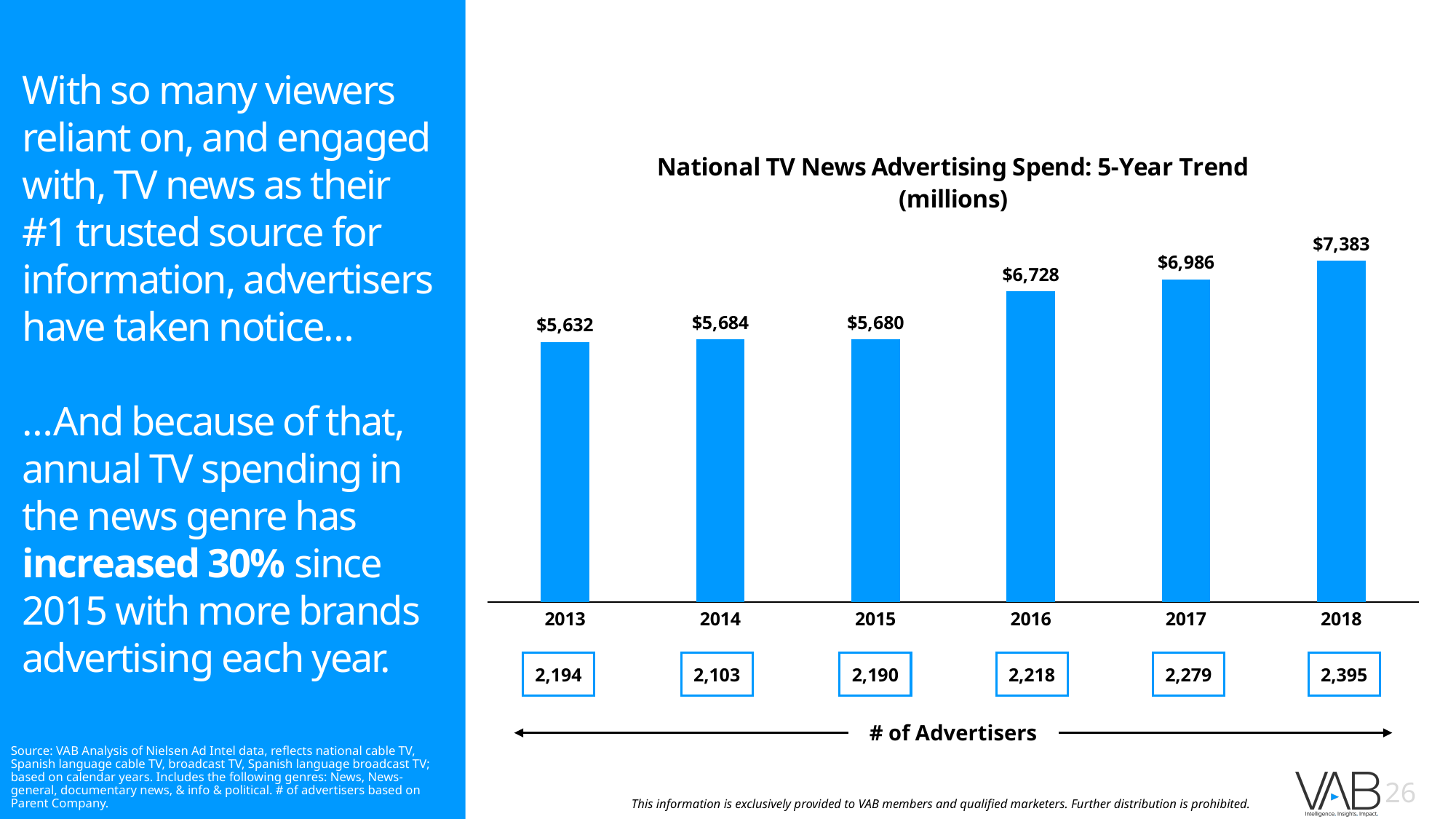
What is the title of the chart? National TV News Advertising Spend: 5-Year Trend (millions) What is the National TV News Advertising Spend value for 2016? $6,728 What is the National TV News Advertising Spend value for 2018? $7,383 What kind of chart is used to show the National TV News Advertising Spend? Bar chart What is the National TV News Advertising Spend value for 2013? $5,632 Which year has a larger advertising spend, 2014 or 2017? 2017 How many years are shown in the chart? 6 What is the difference in advertising spend between 2016 and 2015? $1,048 Which year has the highest National TV News Advertising Spend? 2018 What is the difference in advertising spend between 2018 and 2017? $397 Do the advertising spend values generally rise or fall from 2015 to 2018? Rise Which year has the lowest National TV News Advertising Spend? 2013